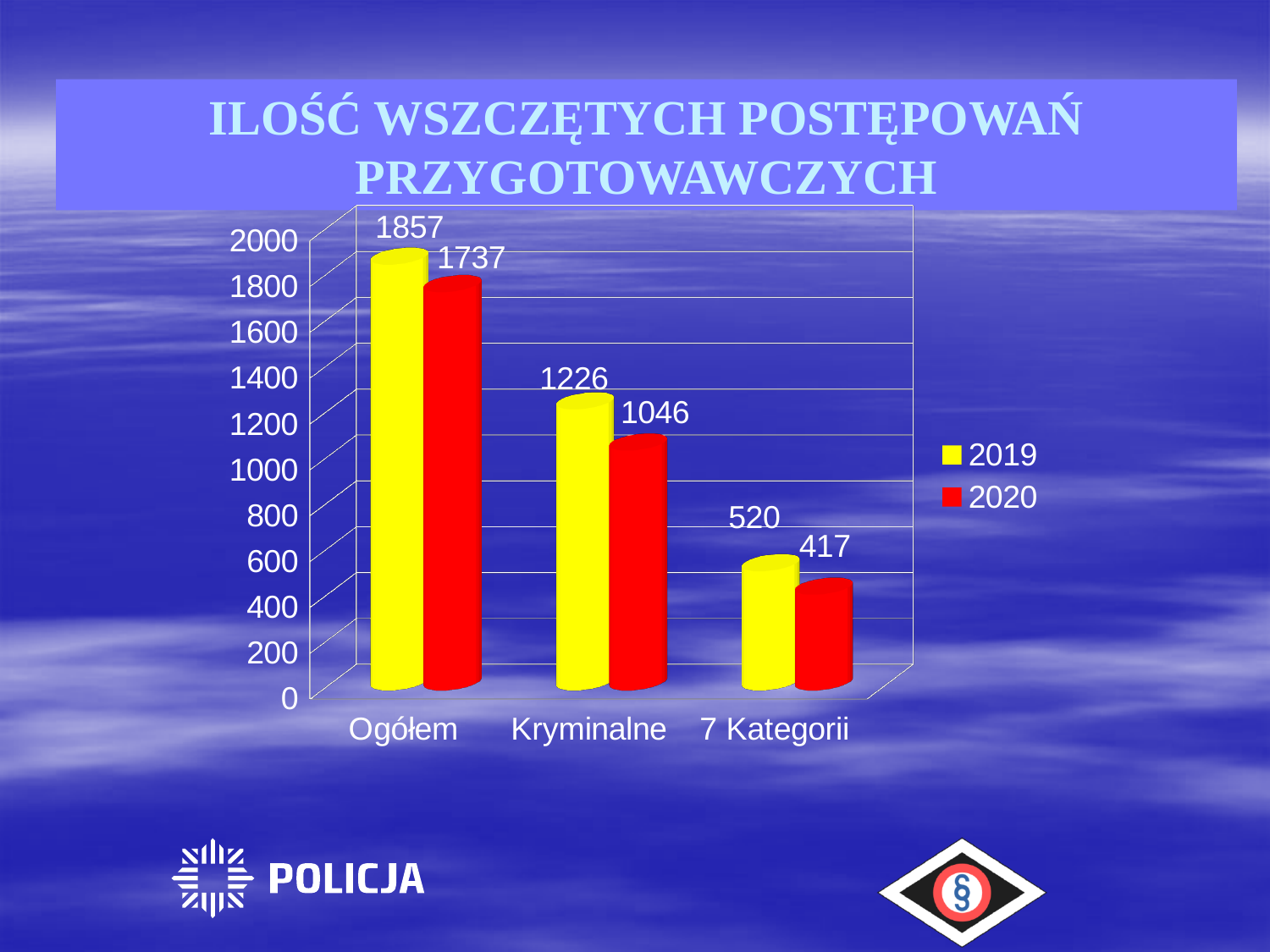
Which colour represents the 2020 series? Red What is the value for 7 Kategorii in 2019? 520 How many categories are shown on the x axis? 3 How many series does the legend list? 2 What is the value for Kryminalne in 2020? 1046 What is the value for Ogółem in 2019? 1857 What kind of chart is shown on the slide? Bar chart Which is larger for 7 Kategorii, the 2019 value or the 2020 value? 2019 What is the difference between the 2019 and 2020 values for Kryminalne? 180 Which category has the lowest value in 2020? 7 Kategorii What is the difference between the 2019 and 2020 values for Ogółem? 120 Which category has the highest value in 2019? Ogółem